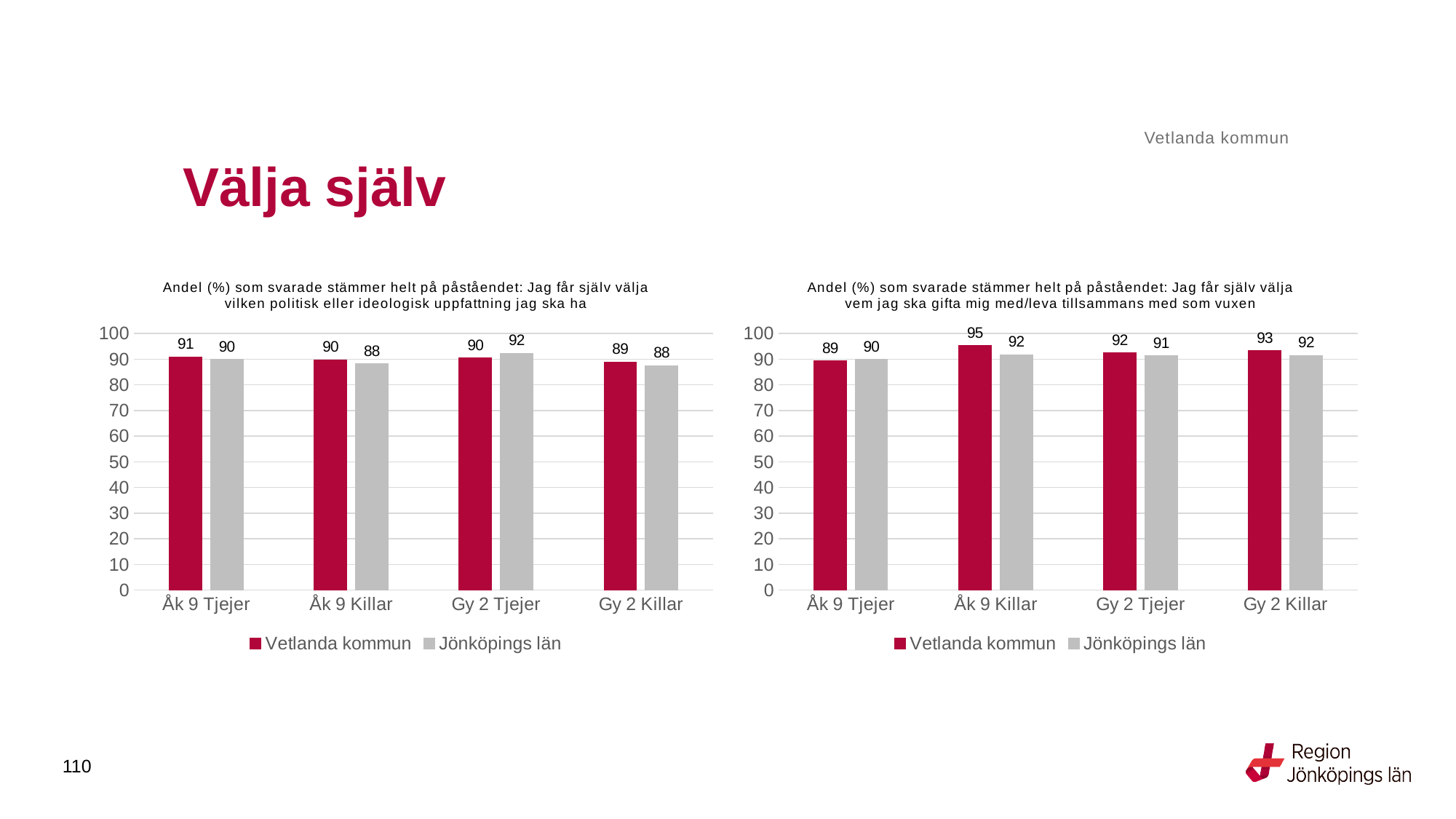
In the left chart (political or ideological opinion), what is the difference between Vetlanda kommun and Jönköpings län for Åk 9 Killar? 2 In the right chart (who to marry/live with), what is the value for Vetlanda kommun for Åk 9 Killar? 95 In the left chart (political or ideological opinion), which is larger for Gy 2 Tjejer: Vetlanda kommun or Jönköpings län? Jönköpings län In the left chart (political or ideological opinion), what is the value for Vetlanda kommun for Åk 9 Tjejer? 91 How many series does the legend of the left chart list? 2 In the right chart (who to marry/live with), which category has the highest Vetlanda kommun value? Åk 9 Killar In the right chart (who to marry/live with), what is the value for Jönköpings län for Gy 2 Killar? 92 In the right chart (who to marry/live with), what is the difference between Vetlanda kommun and Jönköpings län for Åk 9 Killar? 3 In the left chart (political or ideological opinion), which category has the lowest Jönköpings län value? Åk 9 Killar and Gy 2 Killar (both 88) In the left chart (political or ideological opinion), what is the value for Jönköpings län for Gy 2 Tjejer? 92 How many categories are shown on the x axis of the right chart? 4 What type of chart is the left chart? Bar chart